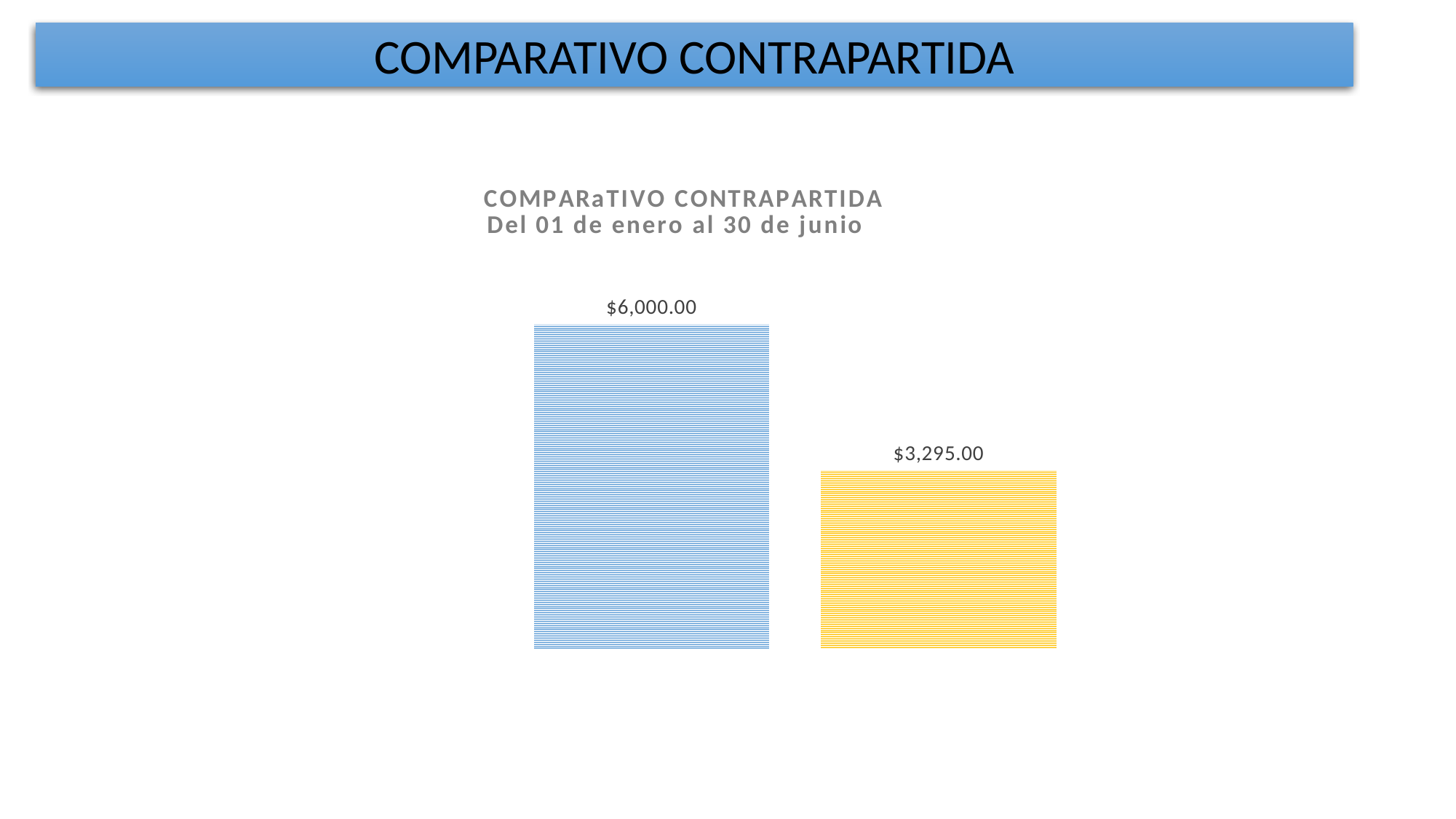
What colour is the bar with the value $3,295.00? Yellow How many bars are plotted in the chart? 2 What kind of chart is shown on the slide? Bar chart What is the total of the two bar values? $9,295.00 What is the difference between the value of the blue bar and the value of the yellow bar? $2,705.00 Which bar has the lower value, the blue bar or the yellow bar? The yellow bar Which bar has the higher value, the blue bar or the yellow bar? The blue bar What period does the chart title say the comparison covers? Del 01 de enero al 30 de junio Is the value of the left bar larger or smaller than the value of the right bar? Larger What value is shown on the blue bar on the left? $6,000.00 What value is shown on the yellow bar on the right? $3,295.00 Do the bar values rise or fall from left to right? Fall